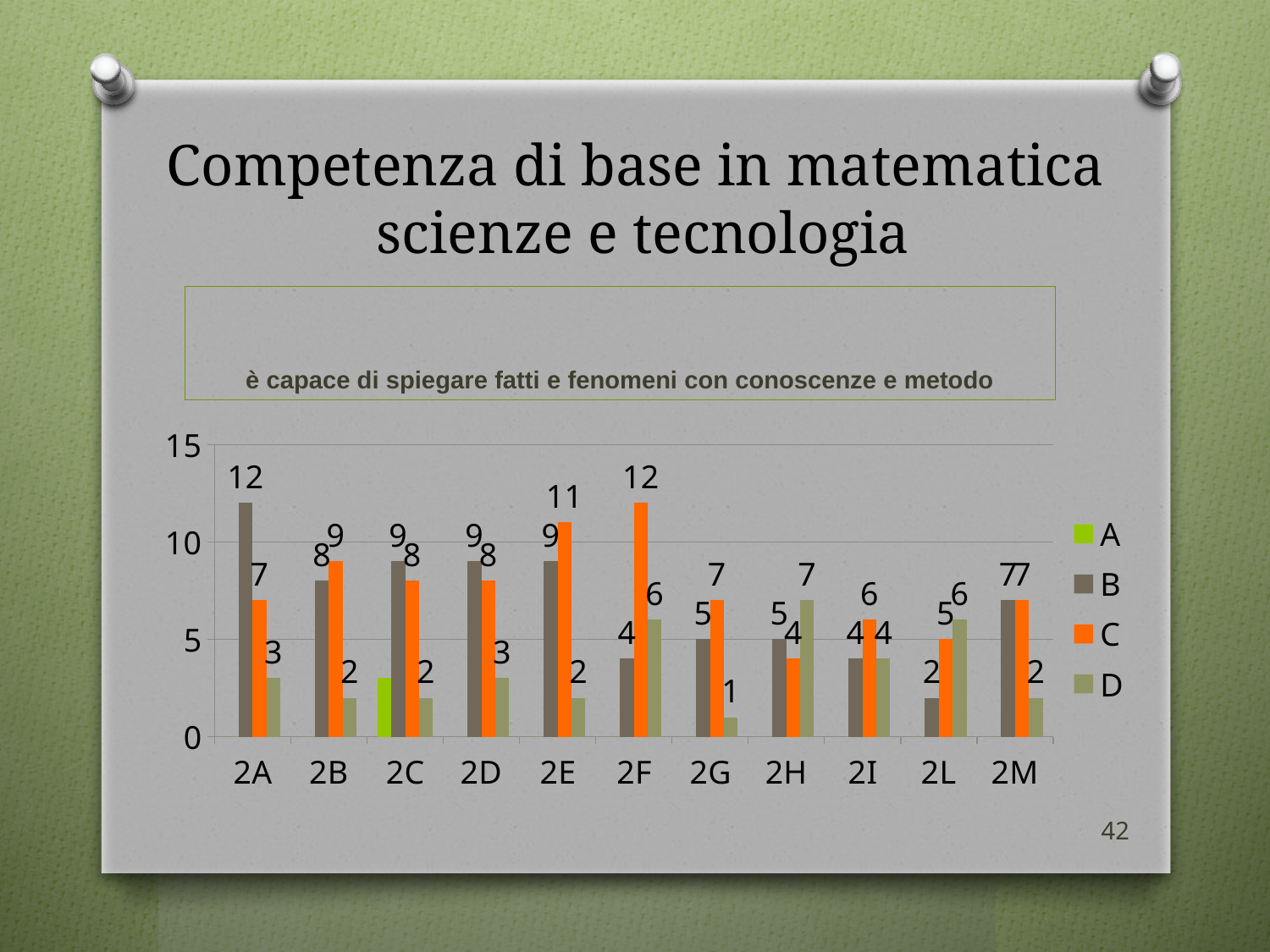
What is the value of series D for class 2L? 6 What is the difference between series B and series C for class 2A? 5 For class 2H, which is larger: series C or series D? D Which class has the highest value for series C? 2F How many series does the legend list? 4 What kind of chart is shown on the slide? bar chart What is the value of series B for class 2A? 12 How many classes (categories) are shown on the x axis? 11 Is the value of series A for class 2C greater or less than 5? less What is the value of series C for class 2F? 12 Which class has the lowest value for series D? 2G Which class has the highest value for series B? 2A